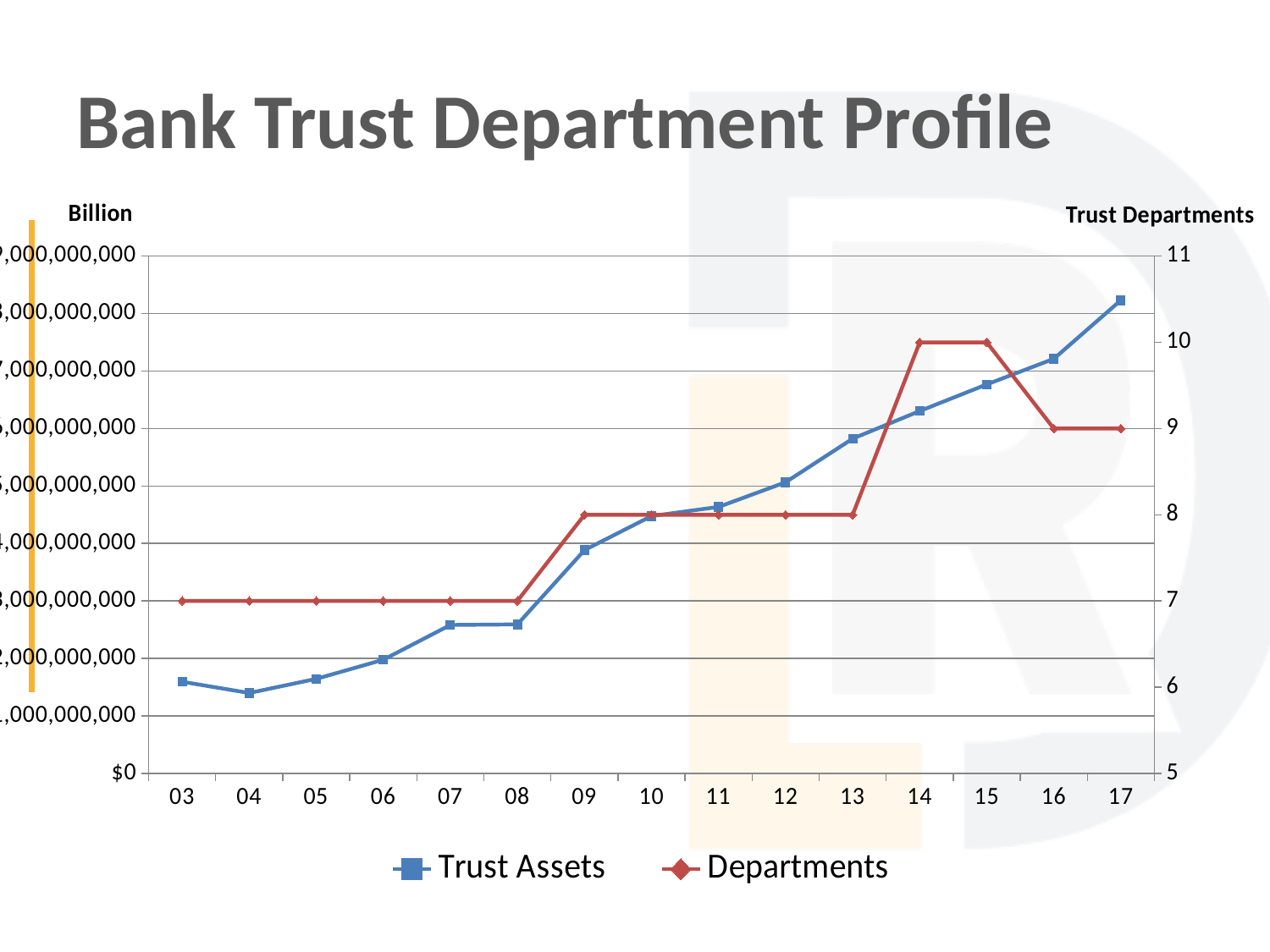
How many series does the legend list? 2 Is the Trust Assets value for 17 greater or less than $8,000,000,000? greater What kind of chart is shown on the slide? line chart Is the Trust Assets value for 04 greater or less than $2,000,000,000? less What is the difference between the Departments value in 15 and the Departments value in 16? 1 What is the value of the Departments series in 17? 9 What is the value of the Departments series in 05? 7 What is the value of the Departments series in 14? 10 What is the value of the Departments series in 11? 8 In which years does the Departments series reach its highest value? 14 and 15 How many years are plotted along the x axis? 15 Does the Trust Assets series generally rise or fall from 03 to 17? rise